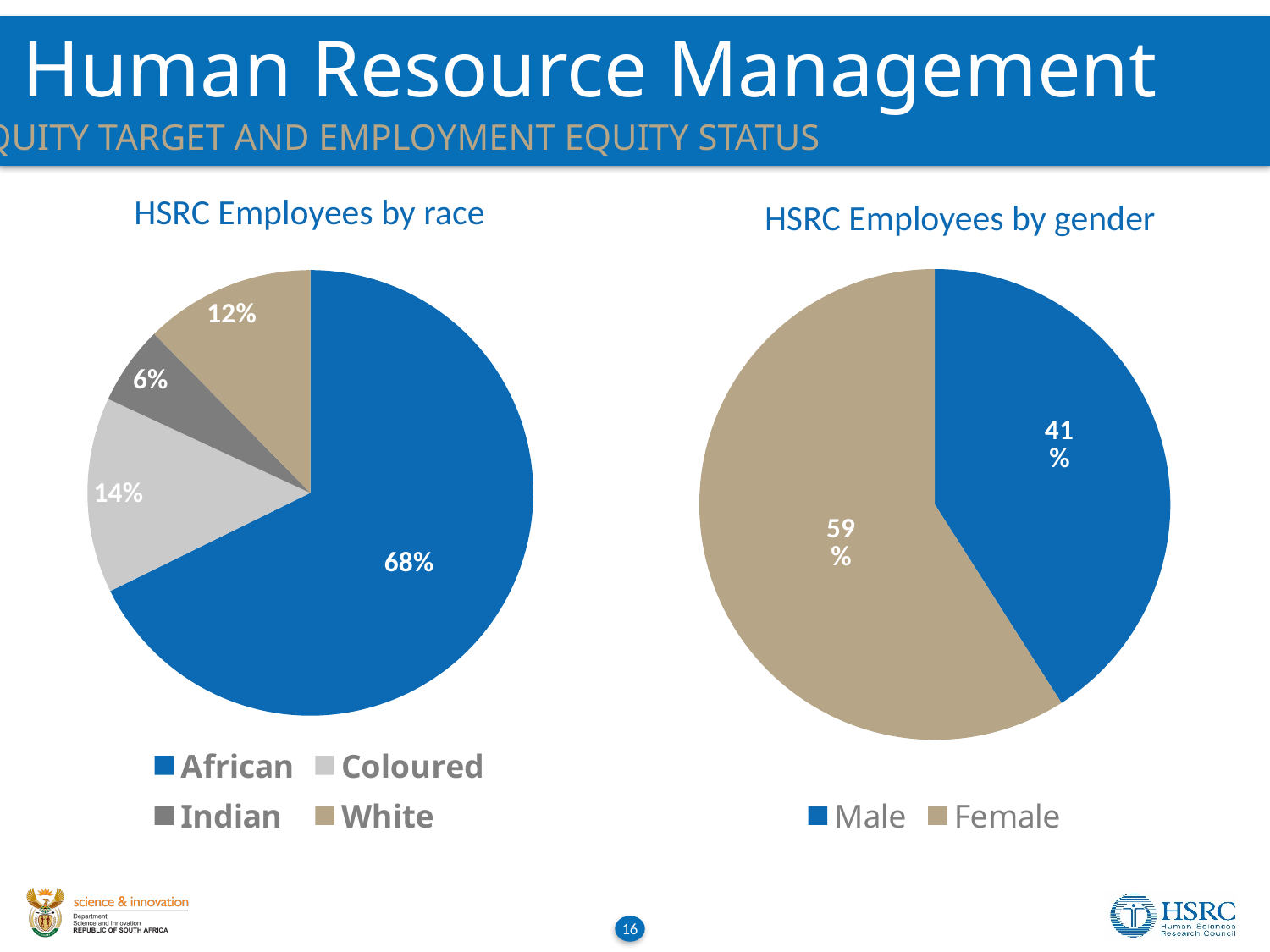
In the 'HSRC Employees by race' chart, which race group has the smallest share? Indian In the 'HSRC Employees by race' chart, what is the difference in percentage points between the African and Coloured shares? 54 In the 'HSRC Employees by race' chart, what percentage of employees are White? 12% What type of chart is 'HSRC Employees by gender'? Pie chart In the 'HSRC Employees by race' chart, what percentage of employees are Indian? 6% In the 'HSRC Employees by race' chart, what percentage of employees are Coloured? 14% In the 'HSRC Employees by gender' chart, what percentage of employees are Female? 59% In the 'HSRC Employees by race' chart, what percentage of employees are African? 68% In the 'HSRC Employees by gender' chart, which gender has the larger share, Male or Female? Female In the 'HSRC Employees by gender' chart, what percentage of employees are Male? 41% In the 'HSRC Employees by race' chart, how many race categories are shown? 4 In the 'HSRC Employees by race' chart, which race group has the largest share? African